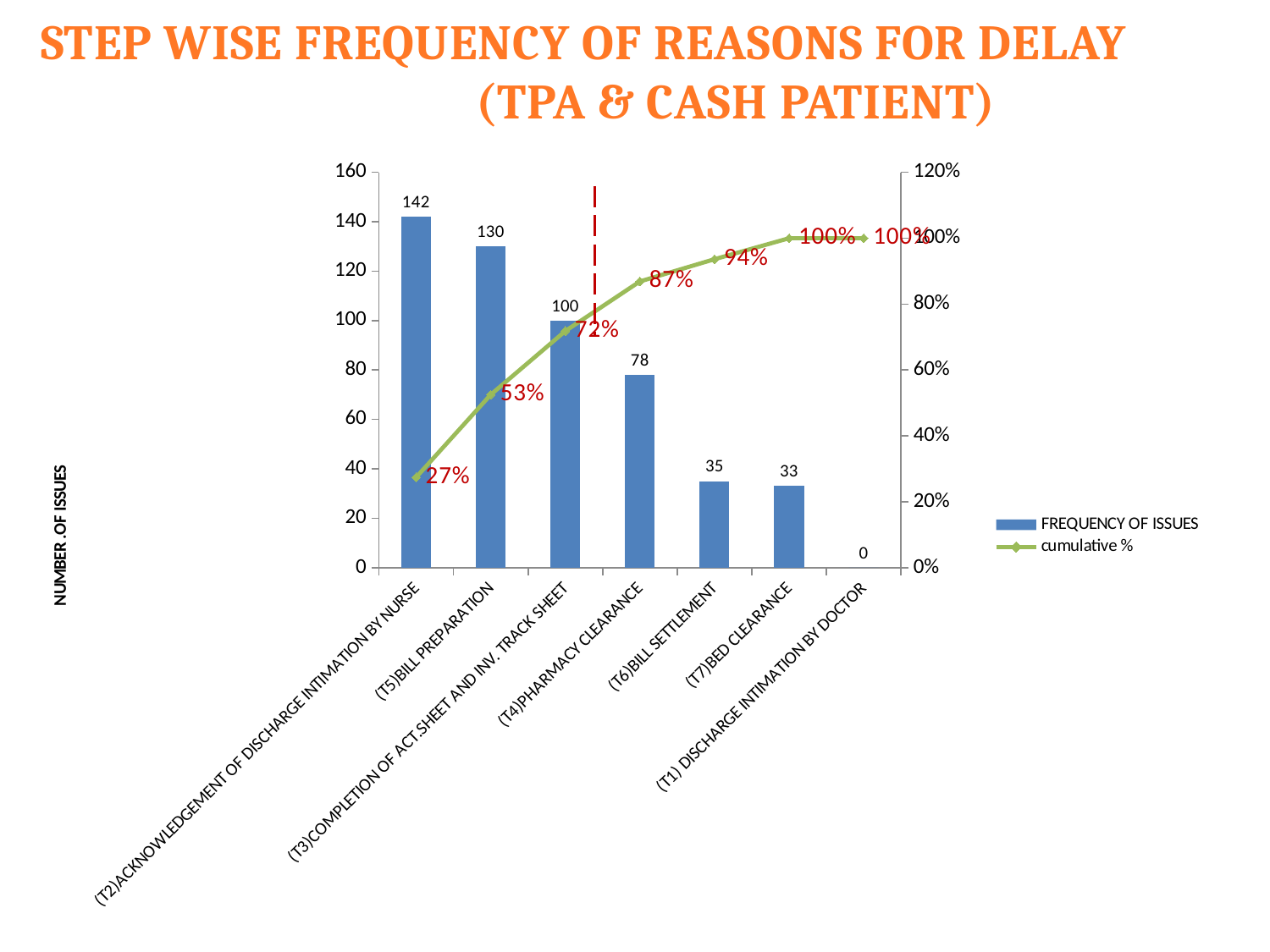
Do the frequency of issues bars rise or fall from left to right along the x axis? Fall How many categories are shown on the x axis? 7 Which category has the highest frequency of issues? (T2) Acknowledgement of Discharge Intimation by Nurse What kind of chart is shown on the slide? Combined bar and line chart Which has a higher frequency of issues, (T6) Bill Settlement or (T4) Pharmacy Clearance? (T4) Pharmacy Clearance What is the frequency of issues for (T4) Pharmacy Clearance? 78 What is the difference in frequency of issues between (T2) Acknowledgement of Discharge Intimation by Nurse and (T5) Bill Preparation? 12 What is the cumulative % at (T3) Completion of Act. Sheet and Inv. Track Sheet? 72% What is the frequency of issues for (T5) Bill Preparation? 130 What is the label of the left vertical axis? NUMBER .OF ISSUES Which category has the lowest frequency of issues? (T1) Discharge Intimation by Doctor How many series does the legend list? 2